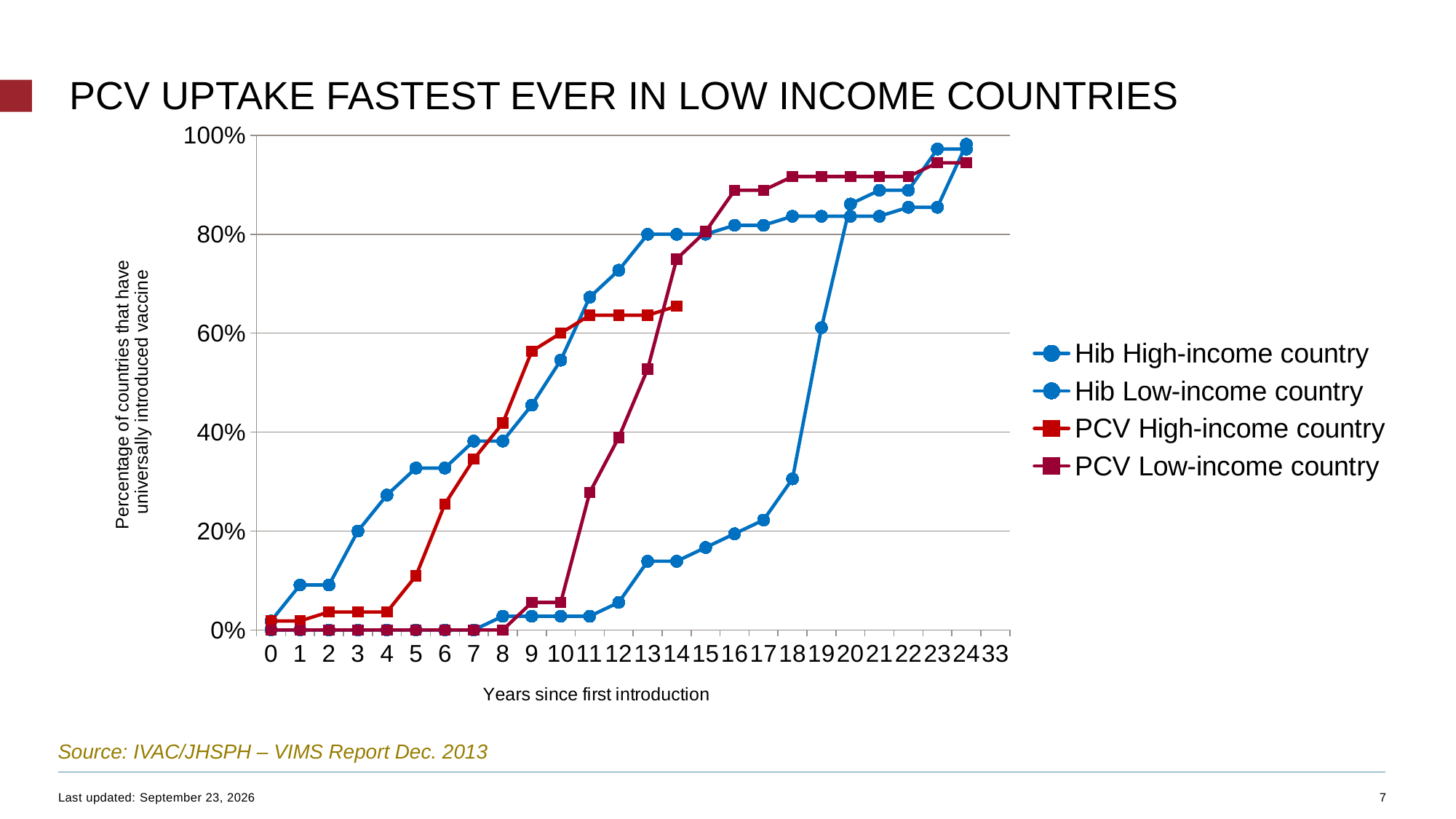
What is the title of the chart's x axis? Years since first introduction At year 10, which is larger: PCV High-income country or Hib High-income country? PCV High-income country Is the value for PCV Low-income country at year 14 greater or less than 80%? less Which series is drawn with red square markers? PCV High-income country Does the Hib Low-income country series generally rise or fall as years since first introduction increase? rise What is the value for PCV Low-income country at year 4? 0% Is the value for Hib Low-income country at year 18 greater or less than 20%? greater Is the value for PCV High-income country at year 9 greater or less than 40%? greater What kind of chart is shown on the slide? line chart How many series does the legend list? 4 At year 20, which is larger: PCV Low-income country or Hib Low-income country? PCV Low-income country